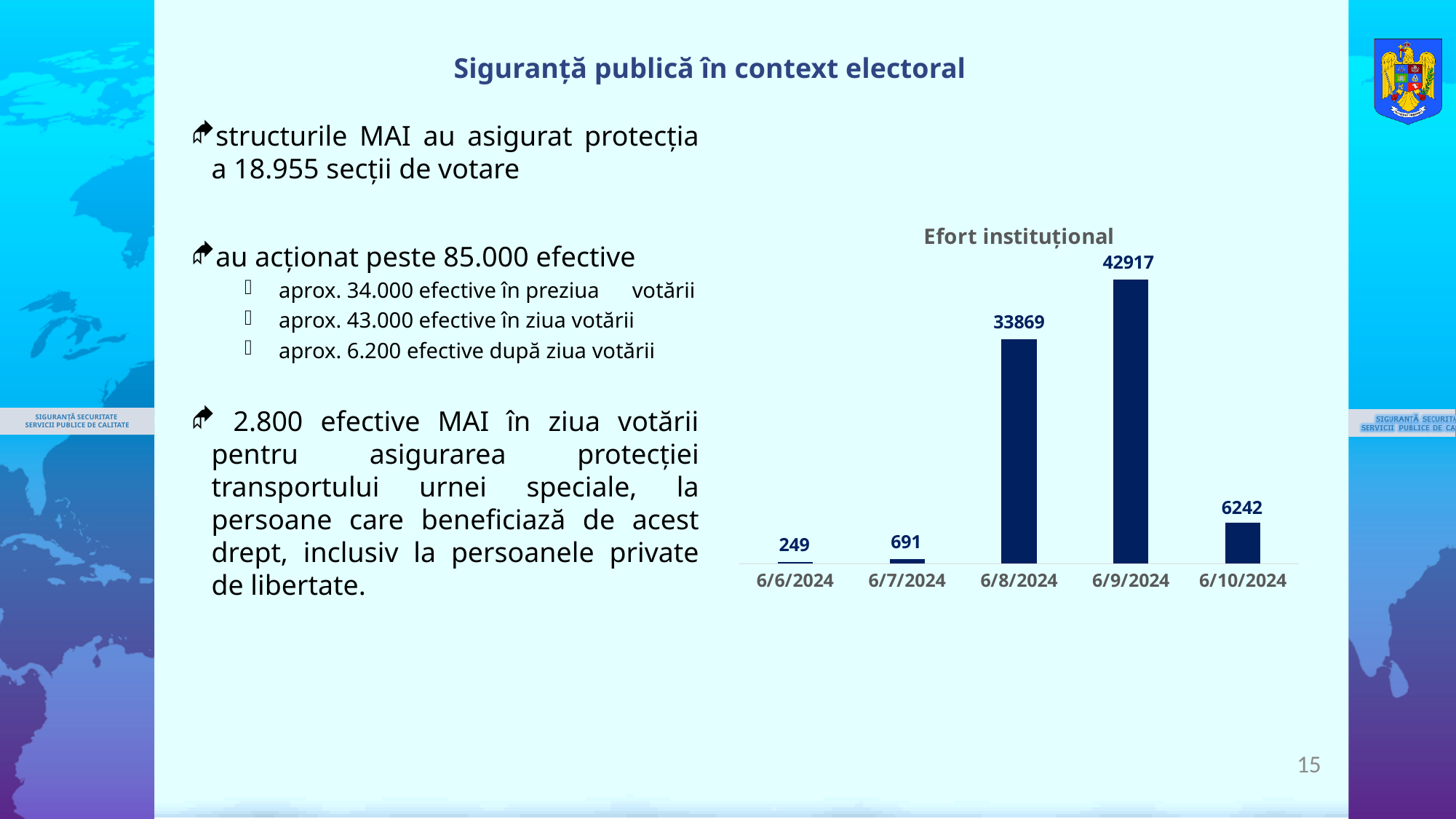
Which date has the lowest value in the Efort instituțional chart? 6/6/2024 What is the value for 6/10/2024 in the Efort instituțional chart? 6242 What is the difference between the values for 6/9/2024 and 6/8/2024? 9048 What is the title of the chart? Efort instituțional What is the value for 6/9/2024 in the Efort instituțional chart? 42917 What kind of chart is shown on the slide? bar chart What is the value for 6/6/2024 in the Efort instituțional chart? 249 Which date has the highest value in the Efort instituțional chart? 6/9/2024 How many dates are shown on the x axis of the chart? 5 Do the values rise or fall from 6/6/2024 to 6/9/2024? rise Which is larger, the value for 6/8/2024 or the value for 6/10/2024? 6/8/2024 What is the difference between the values for 6/7/2024 and 6/6/2024? 442